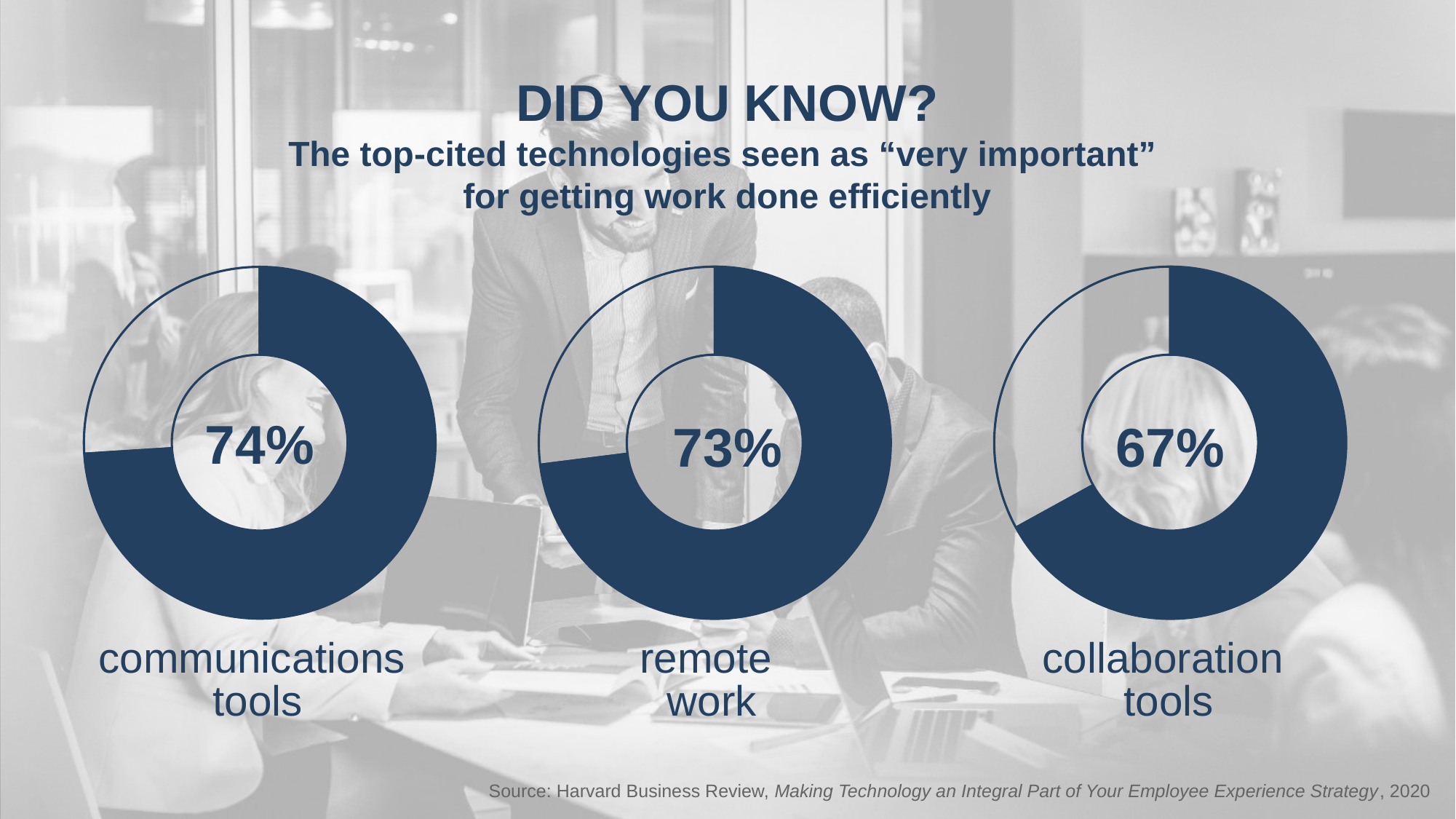
What kind of chart is used to show each percentage on the slide? donut (pie) chart What percentage is shown in the collaboration tools chart? 67% What is the difference in percentage points between communications tools and collaboration tools? 7 percentage points What is the difference in percentage points between communications tools and remote work? 1 percentage point Which has a larger percentage, remote work or collaboration tools? remote work Which of the three technologies has the highest percentage? communications tools How many donut charts are shown on the slide? 3 Which of the three technologies has the lowest percentage? collaboration tools What percentage is shown in the communications tools chart? 74% What percentage is shown in the remote work chart? 73% What is the main heading at the top of the slide? DID YOU KNOW? What is the source cited at the bottom of the slide? Harvard Business Review, Making Technology an Integral Part of Your Employee Experience Strategy, 2020